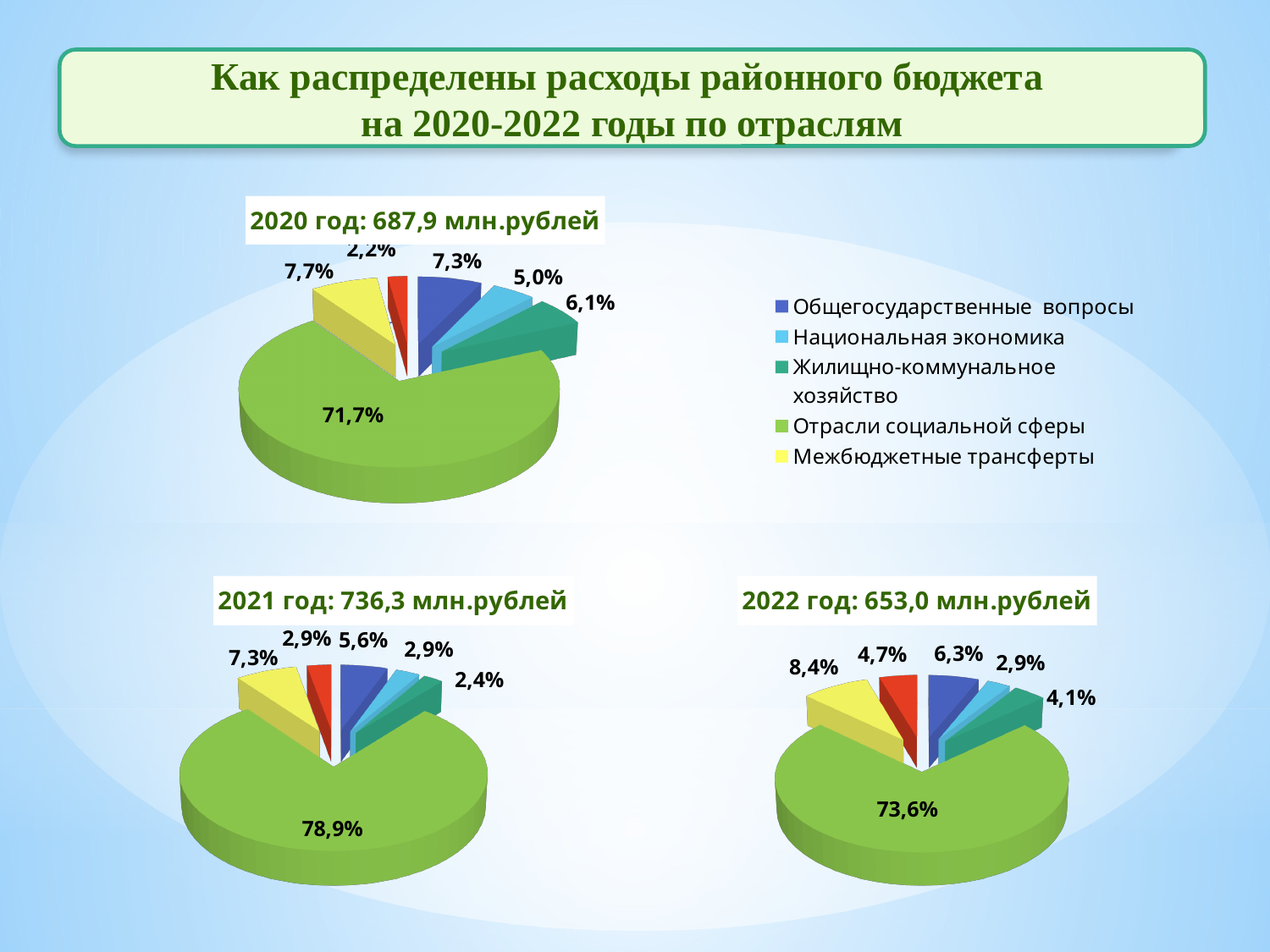
What total amount is stated in the title of the 2021 chart? 736,3 млн.рублей On the 2021 pie chart, which category has the largest share? Отрасли социальной сферы On the 2021 pie chart, what share is shown for Межбюджетные трансферты? 7,3% On the 2020 pie chart, what is the difference between the shares of Межбюджетные трансферты and Общегосударственные вопросы? 0,4% What kind of chart is used for the 2022 data? Pie chart On the 2021 pie chart, which is larger: the share of Общегосударственные вопросы or the share of Жилищно-коммунальное хозяйство? Общегосударственные вопросы How many categories does the legend on the slide list? 5 On the 2020 pie chart, what share is shown for Национальная экономика? 5,0% On the 2022 pie chart, which legend category has the smallest share? Национальная экономика On the 2022 pie chart, what share is shown for Жилищно-коммунальное хозяйство? 4,1% On the 2022 pie chart, what share is shown for Общегосударственные вопросы? 6,3% On the 2020 pie chart, what share is shown for Отрасли социальной сферы? 71,7%